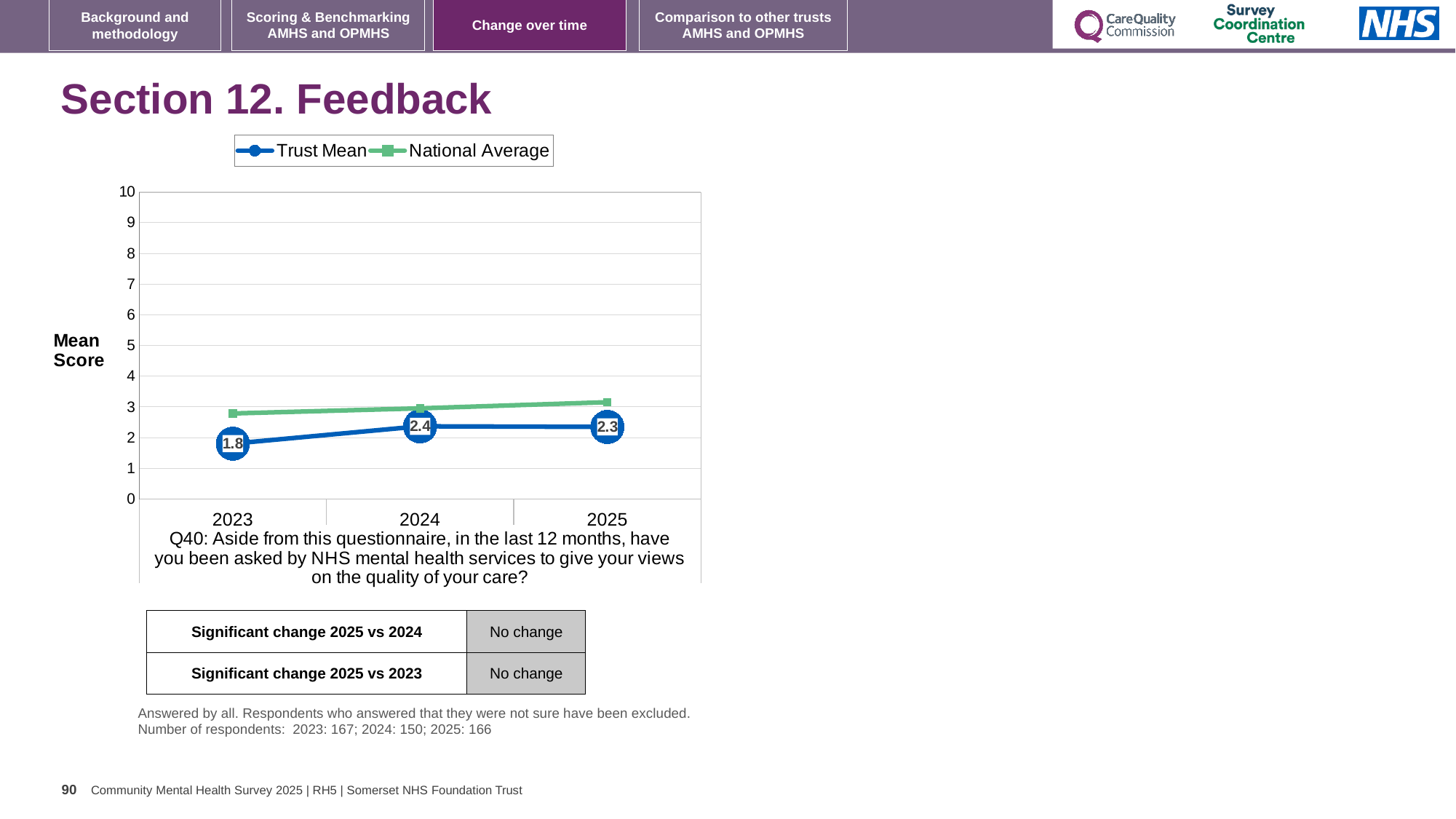
How many years are plotted on the x axis? 3 What is the difference between the Trust Mean in 2024 and in 2025? 0.1 By how much did the Trust Mean increase from 2023 to 2024? 0.6 What is the Trust Mean score for 2024? 2.4 How many series does the legend list? 2 In which year is the Trust Mean lowest? 2023 What is the Trust Mean score for 2023? 1.8 What kind of chart is shown on the slide? line chart In which year is the Trust Mean highest? 2024 Which year has the larger Trust Mean, 2023 or 2025? 2025 Is the National Average value for 2023 greater or less than 3? less What is the Trust Mean score for 2025? 2.3